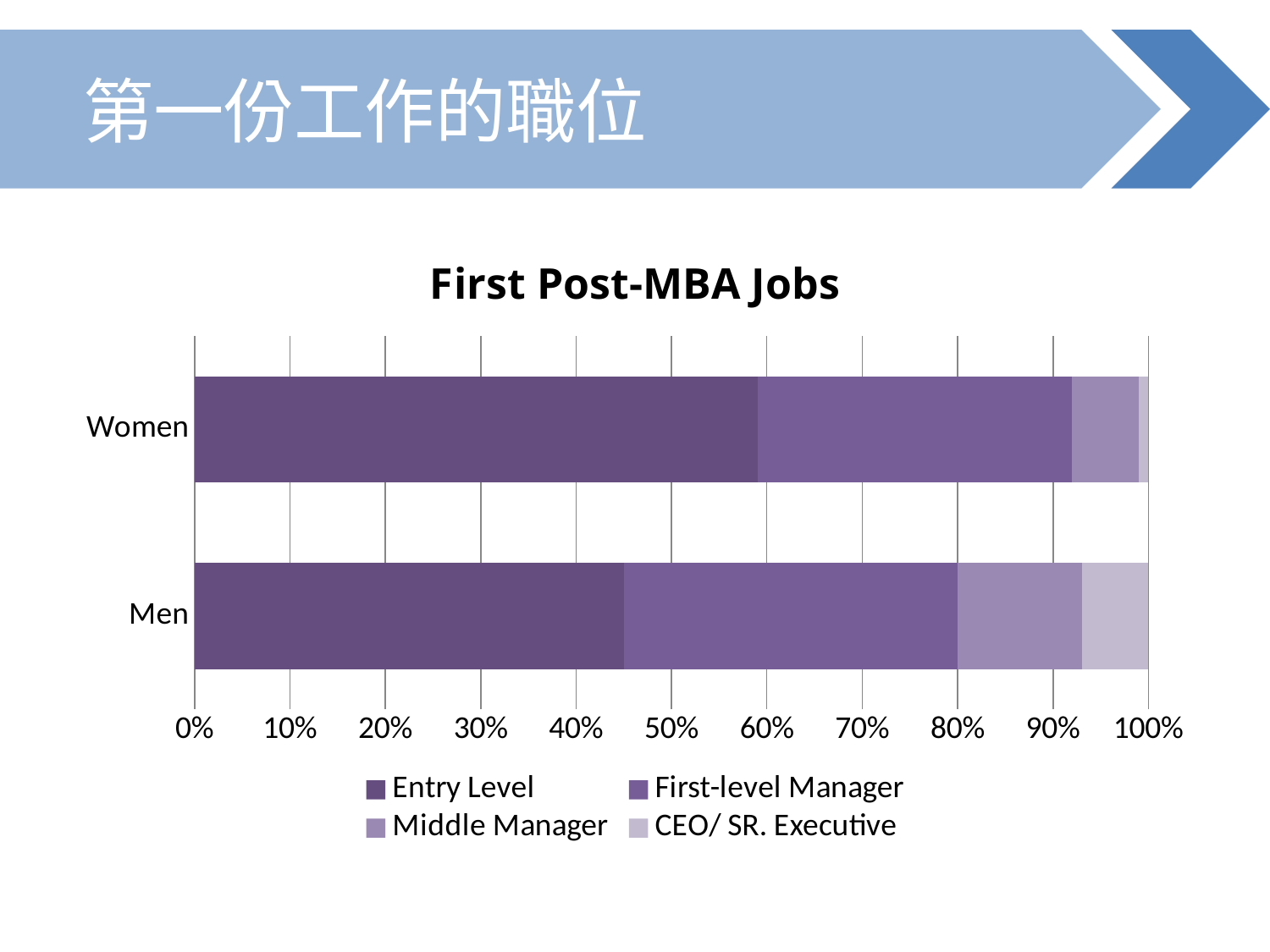
What is the total of the stacked bar for Men? 100% Is the Entry Level share for Men greater or less than 40%? greater What is the title of the chart? First Post-MBA Jobs What kind of chart is shown on the slide? Stacked bar chart Which category has the larger CEO/ SR. Executive share, Women or Men? Men Is the Entry Level share for Men greater or less than 50%? less How many series does the legend list? 4 Is the Entry Level share for Women greater or less than 50%? greater Which series is listed last in the legend? CEO/ SR. Executive Which category has the larger Entry Level share, Women or Men? Women How many categories are shown on the vertical axis? 2 Which category has the larger Middle Manager share, Women or Men? Men